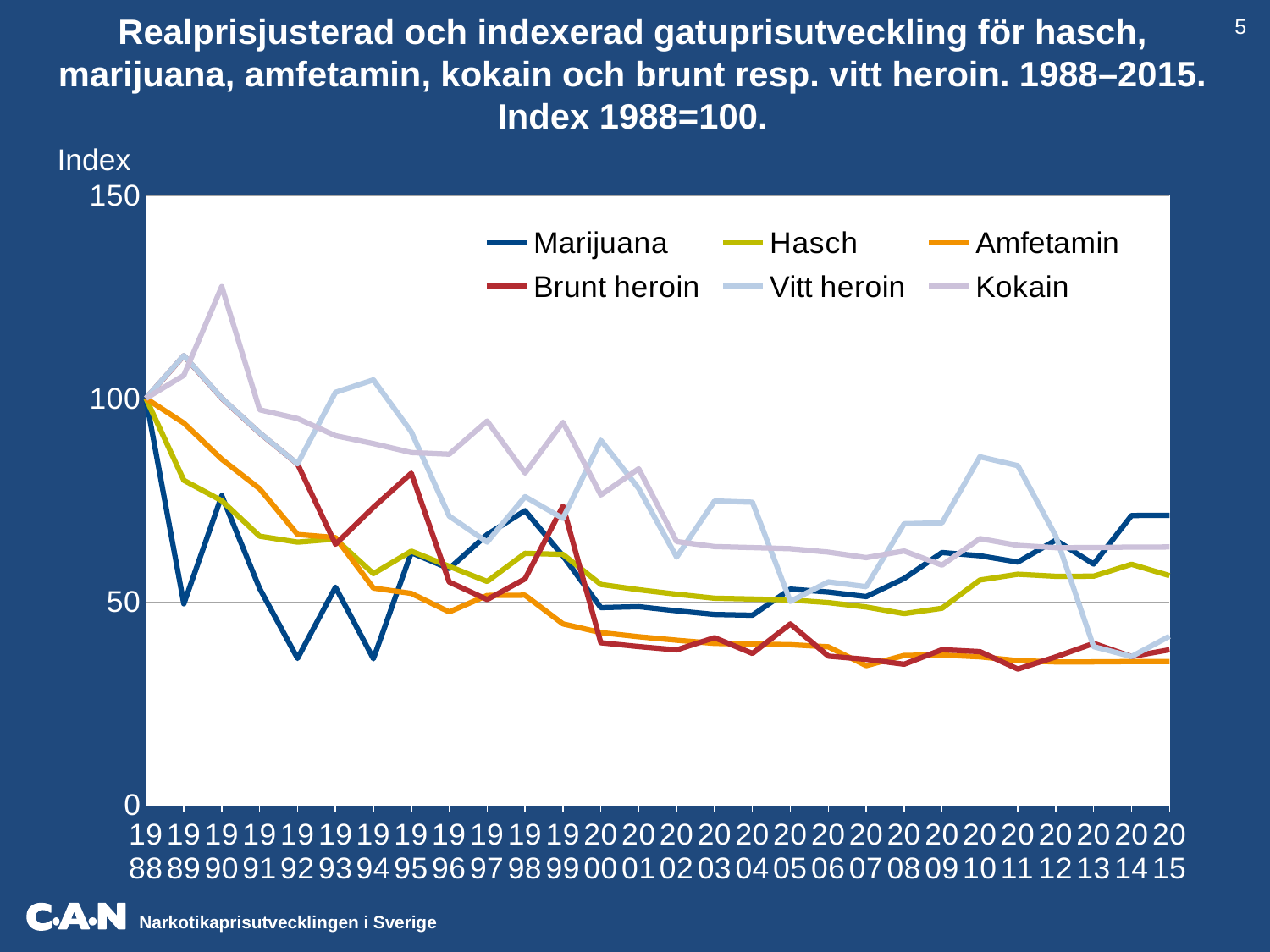
Which series has the highest value in 1990? Kokain Is the value for Hasch in 2015 greater or less than 50? greater Overall, do the index values rise or fall from 1988 to 2015? fall What is the label on the y axis? Index Which is larger in 1992, the value for Kokain or the value for Marijuana? Kokain What kind of chart is shown on the slide? line chart Is the value for Kokain in 1990 greater or less than 100? greater Is the value for Marijuana in 1992 greater or less than 50? less What is the index value for all series in 1988? 100 How many series does the legend list? 6 How many years are shown along the x axis? 28